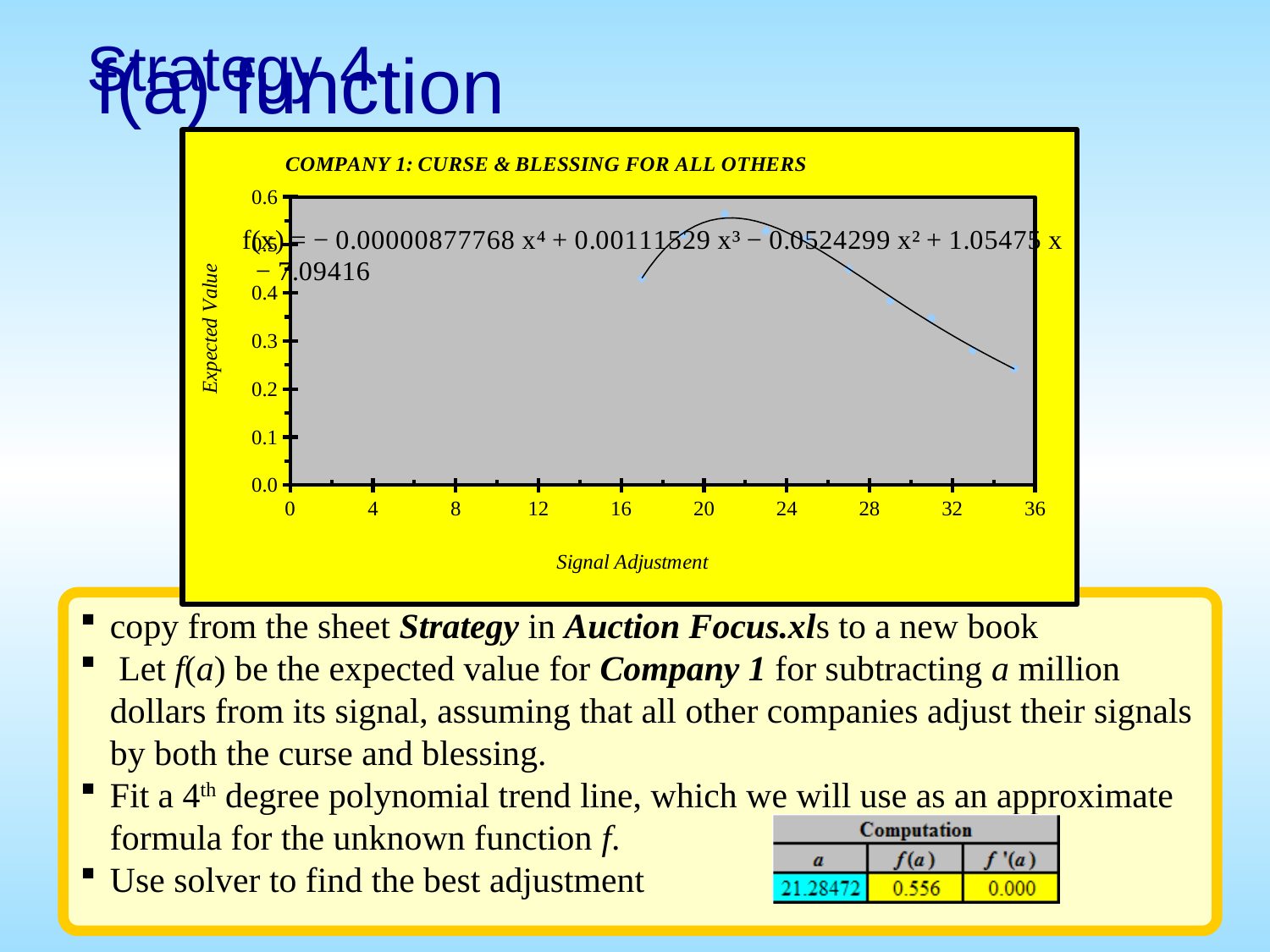
Is the expected value at a signal adjustment of 17 greater or less than 0.5? less Is the highest plotted expected value greater or less than 0.5? greater Which has the larger expected value: a signal adjustment of 25 or of 31? 25 Is the expected value at a signal adjustment of 35 greater or less than 0.3? less What is the maximum value shown on the x axis? 36 Do the expected values rise or fall as the signal adjustment increases from 23 to 35? fall What is the label of the x axis of the chart? Signal Adjustment What is the maximum value shown on the y axis? 0.6 What kind of chart is shown on the slide? scatter chart Which has the larger expected value: a signal adjustment of 19 or of 33? 19